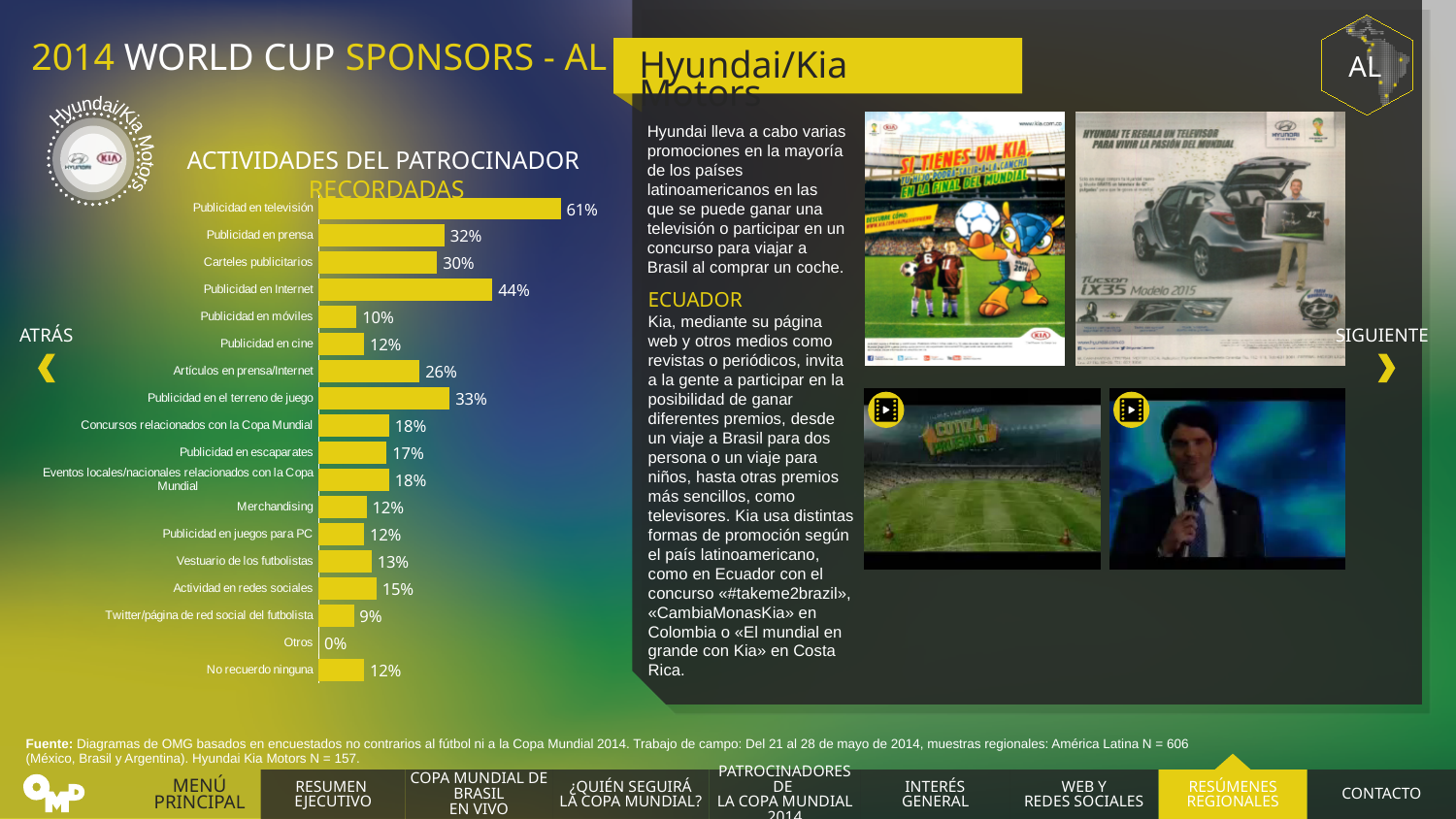
What is the difference between Publicidad en televisión and Publicidad en Internet? 17% What is the value for Twitter/página de red social del futbolista? 9% Which category has the highest value? Publicidad en televisión What is the title of the chart? ACTIVIDADES DEL PATROCINADOR RECORDADAS What is the value for Publicidad en Internet? 44% Which category has the lowest value? Otros How many categories are shown in the chart? 18 Which is larger, Publicidad en prensa or Publicidad en el terreno de juego? Publicidad en el terreno de juego What type of chart is shown on the slide? Bar chart What is the difference between Carteles publicitarios and Artículos en prensa/Internet? 4% What is the value for Publicidad en televisión? 61% What is the value for Actividad en redes sociales? 15%